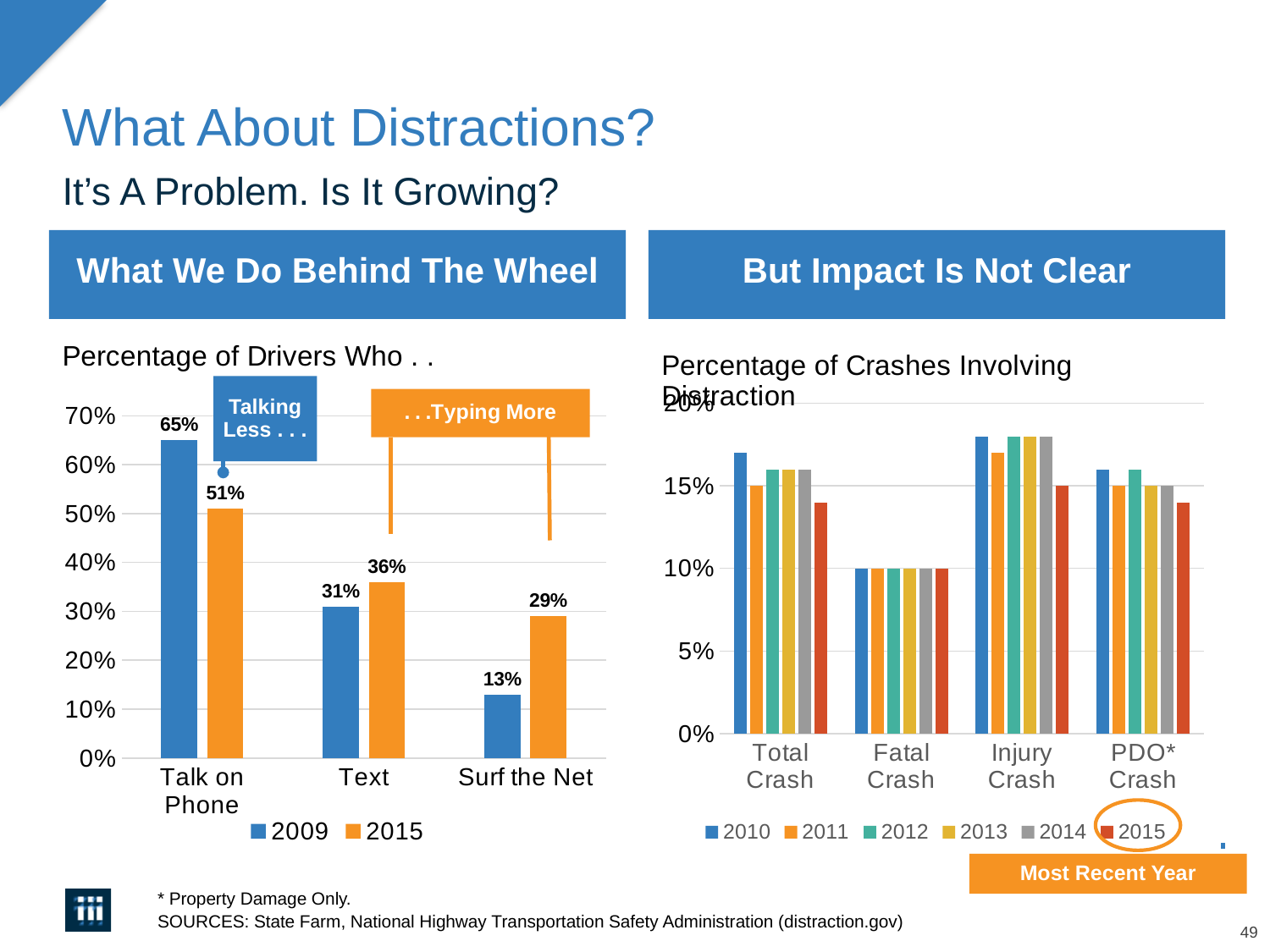
In the right chart, how many crash categories are shown on the x axis? 4 In the left chart, how many series does the legend list? 2 In the left chart, what is the difference between the 2009 and 2015 values for Talk on Phone? 14% What kind of chart is the right chart, Percentage of Crashes Involving Distraction? Bar chart In the right chart, how many series does the legend list? 6 In the right chart, is the 2010 value for Total Crash greater or less than 15%? greater In the left chart, what percentage of drivers talked on the phone in 2009? 65% In the left chart, what is the 2015 value for Text? 36% In the right chart, is the 2015 value for PDO* Crash greater or less than 15%? less In the left chart, which is larger for Text: the 2009 value or the 2015 value? 2015 In the left chart, what percentage of drivers surfed the net in 2015? 29% In the left chart, which category has the lowest value for 2009? Surf the Net